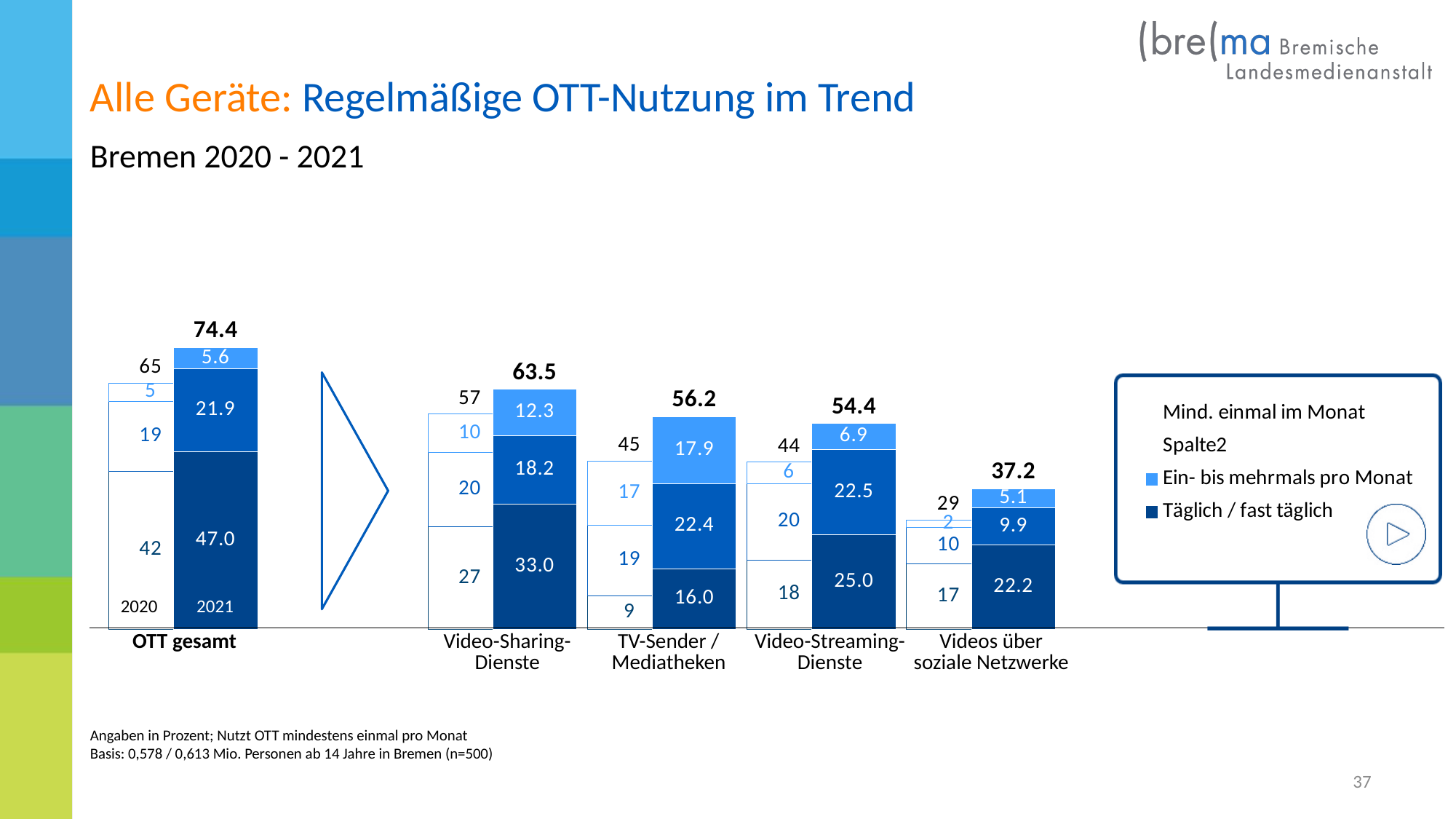
What is the total regular OTT usage for OTT gesamt in 2021? 74.4 What kind of chart is shown on the slide? Stacked bar chart Which has the larger Täglich / fast täglich value in 2021: TV-Sender / Mediatheken or Video-Streaming-Dienste? Video-Streaming-Dienste What is the 2021 value for Ein- bis mehrmals pro Monat for Videos über soziale Netzwerke? 5.1 Do the 2021 totals rise or fall from left to right across the categories? Fall How many categories are shown on the x axis of the chart? 5 What is the 2020 total for TV-Sender / Mediatheken? 45 Which category has the lowest 2021 total? Videos über soziale Netzwerke By how much did the OTT gesamt total increase from 2020 (65) to 2021 (74.4)? 9.4 Which category has the highest 2021 total? OTT gesamt What is the 2021 value for Täglich / fast täglich for Video-Sharing-Dienste? 33.0 Which legend entry corresponds to the dark blue segments? Täglich / fast täglich